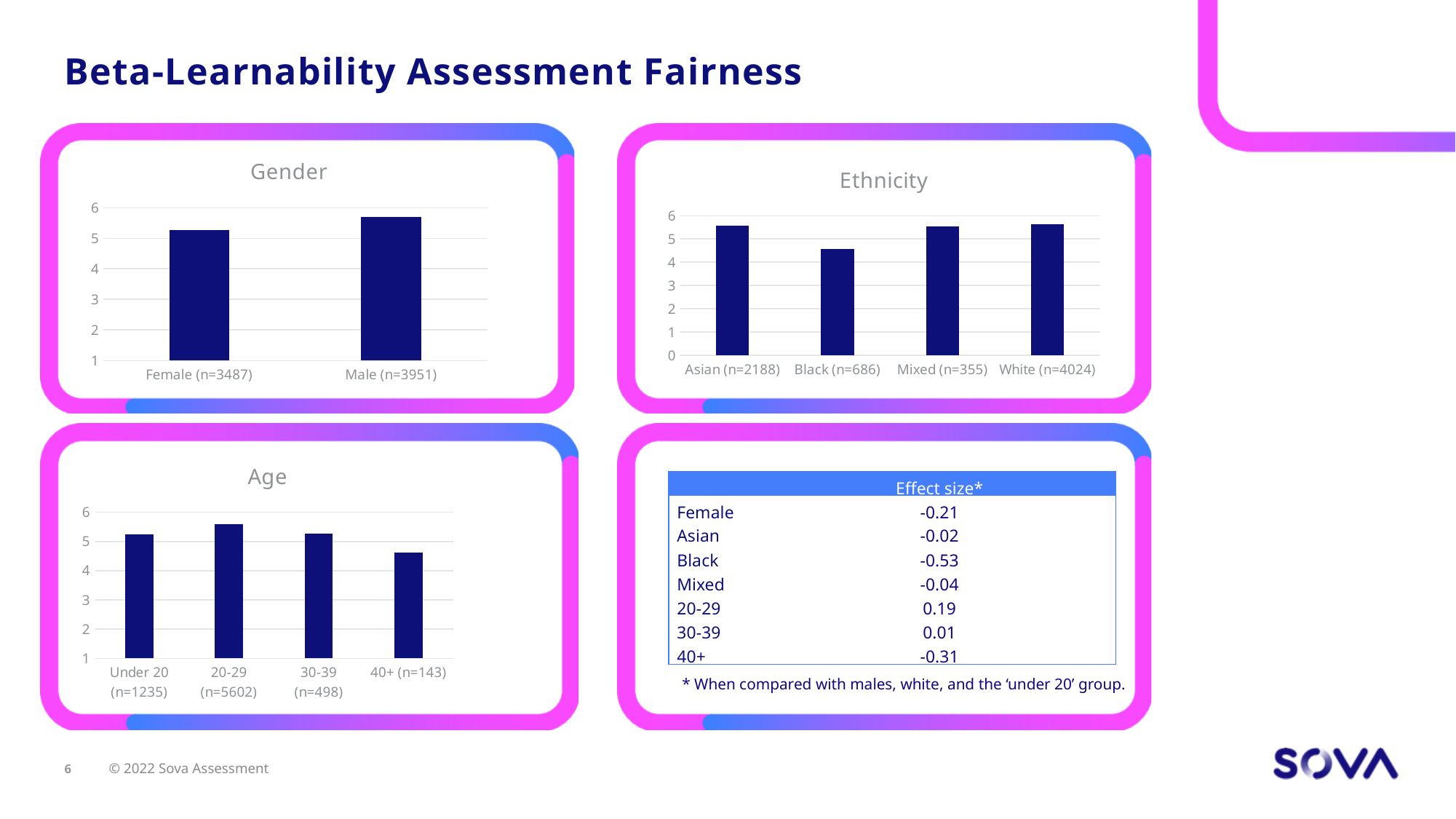
In the Ethnicity chart, is the value for Asian (n=2188) greater or less than 5? greater In the Age chart, is the value for 40+ (n=143) greater or less than 5? less What kind of chart is the Ethnicity chart? bar chart In the Age chart, which category has the lowest value? 40+ (n=143) How many categories are shown in the Ethnicity chart? 4 In the Ethnicity chart, is the value for Black (n=686) greater or less than 5? less In the Ethnicity chart, which category has the lowest value? Black (n=686) What is the title of the chart in the bottom-left panel of the slide? Age In the Gender chart, which category has the higher value, Female (n=3487) or Male (n=3951)? Male (n=3951) How many categories are shown in the Gender chart? 2 In the Age chart, which category has the higher value, 20-29 (n=5602) or 40+ (n=143)? 20-29 (n=5602)